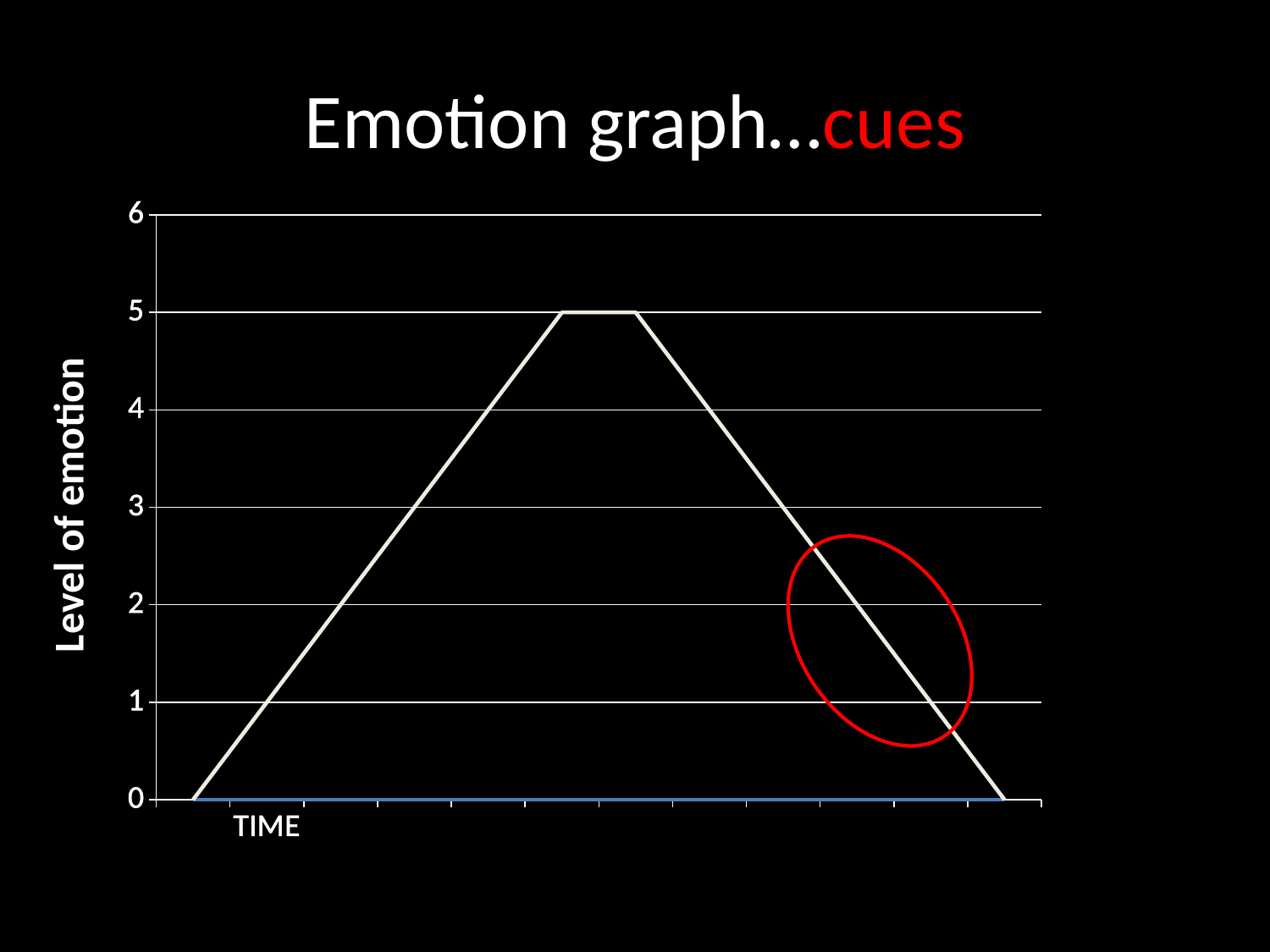
Does the line rise or fall over the second half of the time axis? fall What is the highest level of emotion reached by the line? 5 What is the difference between the peak level of emotion and the starting level? 5 Is the peak level of emotion greater or less than 4? greater What is the level of emotion at the end of the line? 0 What is the title of the chart on the slide? Emotion graph…cues What is the label on the vertical axis of the chart? Level of emotion What is the maximum value shown on the vertical axis? 6 What is the level of emotion at the start of the line? 0 What kind of chart is shown on the slide? line chart What is the lowest level of emotion shown by the line? 0 Does the line rise or fall over the first half of the time axis? rise